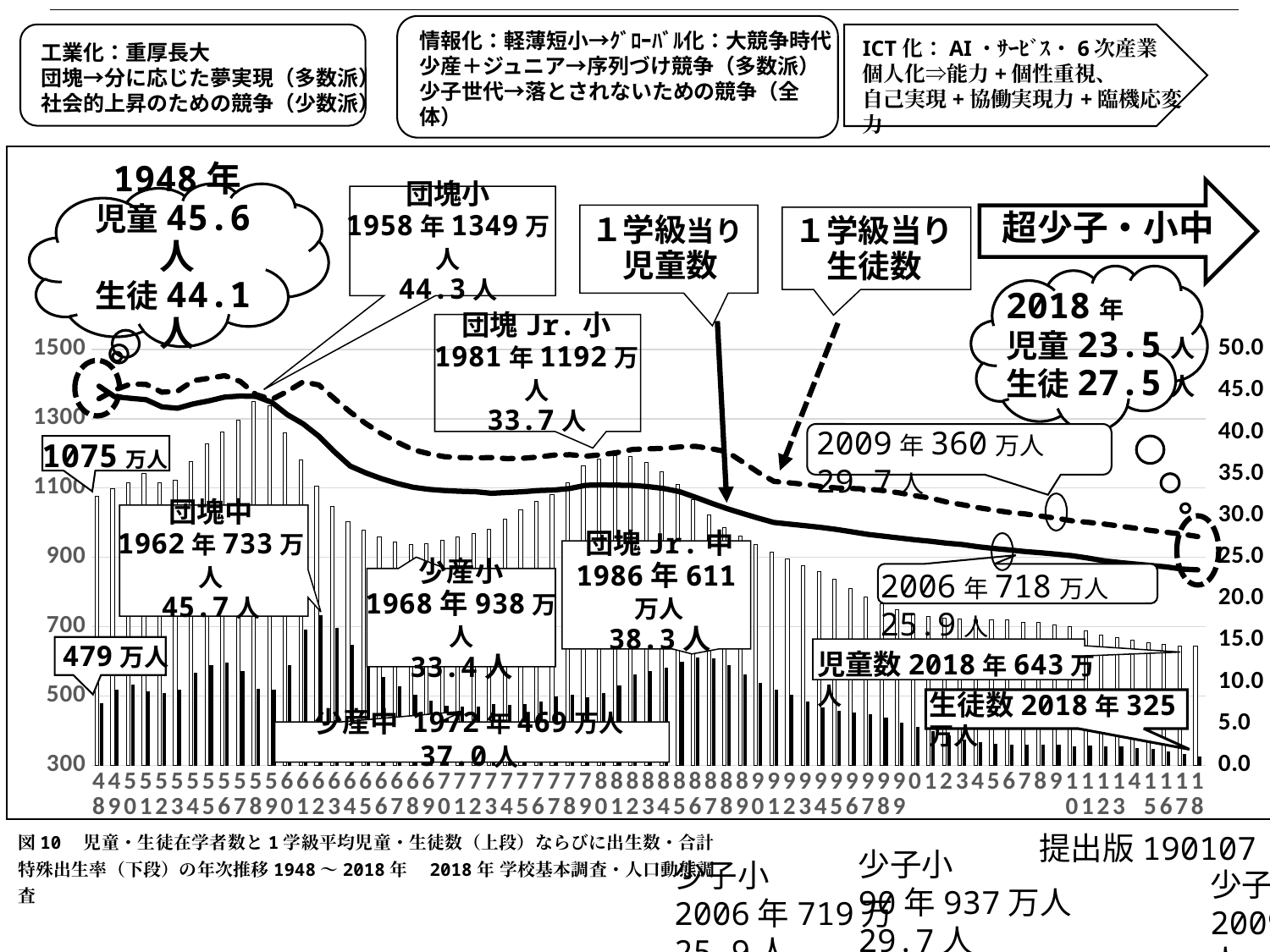
What was the 1学級当り生徒数 (students per class) in 2018? 27.5人 What is the 児童数 (number of elementary pupils) for 2018 shown on the chart? 643万人 What is the difference between the 1学級当り児童数 in 1948 (45.6人) and in 2018 (23.5人)? 22.1人 By how much did the 児童数 fall from 1958 (1349万人) to 2018 (643万人)? 706万人 What was the 1学級当り児童数 (pupils per class) in 1948? 45.6人 What is the 生徒数 for 1972 (少産中) shown in the callout? 469万人 Does the solid line for 1学級当り児童数 rise or fall overall from 1948 to 2018? Fall According to the callout, how many 児童 (elementary pupils) were there in 1958 (団塊小)? 1349万人 What is the 生徒数 (number of junior high students) for 2018 shown on the chart? 325万人 Which year had the larger 生徒数: 1962 (団塊中) or 1986 (団塊Jr.中)? 1962 According to the callout, how many 児童 were there in 1981 (団塊Jr.小)? 1192万人 What kind of chart is shown on the slide? A combination of bar and line chart